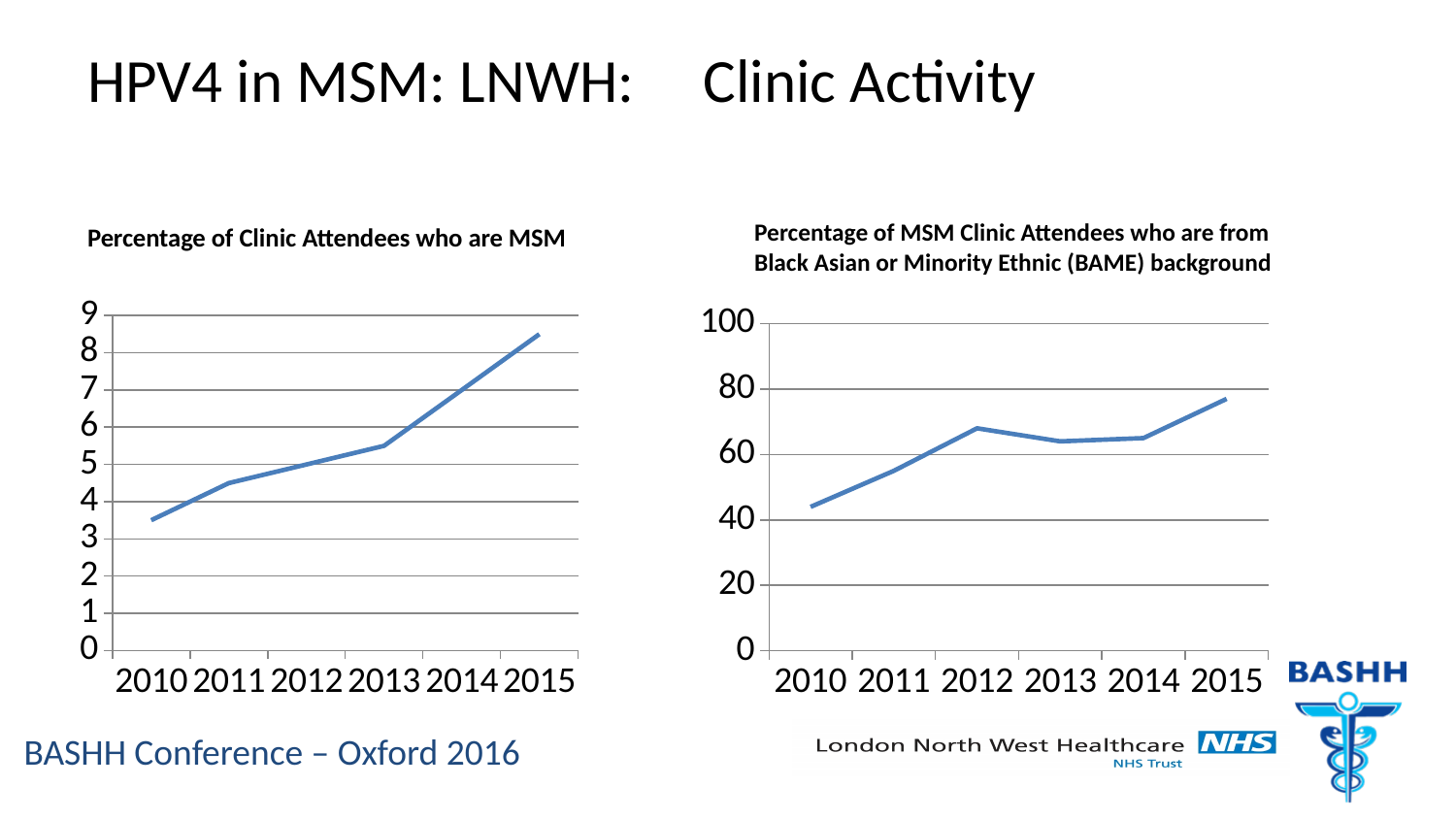
In the left chart, 'Percentage of Clinic Attendees who are MSM', do the values rise or fall from 2010 to 2015? rise In the right chart, 'Percentage of MSM Clinic Attendees who are from Black Asian or Minority Ethnic (BAME) background', which year has the lowest value? 2010 In the left chart, 'Percentage of Clinic Attendees who are MSM', which year has the lowest value? 2010 In the right chart, 'Percentage of MSM Clinic Attendees who are from Black Asian or Minority Ethnic (BAME) background', is the value for 2010 greater or less than 40? greater In the left chart, 'Percentage of Clinic Attendees who are MSM', which year has the highest value? 2015 What type of chart is the left chart, 'Percentage of Clinic Attendees who are MSM'? Line chart In the right chart, 'Percentage of MSM Clinic Attendees who are from Black Asian or Minority Ethnic (BAME) background', which year has the highest value? 2015 In the left chart, 'Percentage of Clinic Attendees who are MSM', is the value for 2010 greater or less than 4? less In the right chart, 'Percentage of MSM Clinic Attendees who are from Black Asian or Minority Ethnic (BAME) background', is the value for 2015 greater or less than 80? less In the right chart, 'Percentage of MSM Clinic Attendees who are from Black Asian or Minority Ethnic (BAME) background', does the value rise or fall between 2012 and 2013? fall How many years are plotted on the x axis of the left chart, 'Percentage of Clinic Attendees who are MSM'? 6